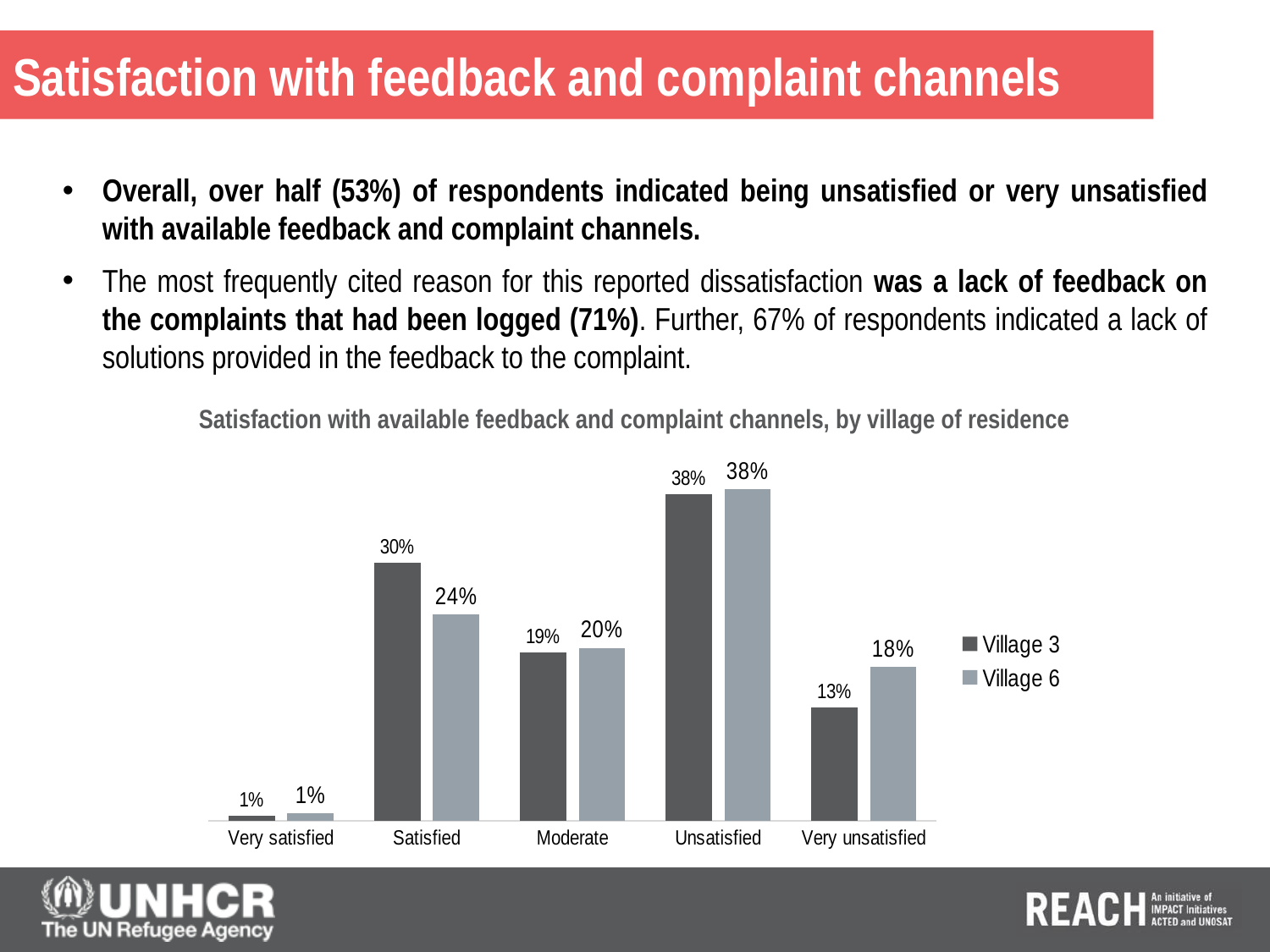
Which is larger in the Satisfied category, Village 3 or Village 6? Village 3 What is the difference between Village 3 and Village 6 in the Satisfied category? 6% What is the value for Village 3 in the Satisfied category? 30% What is the value for Village 6 in the Very unsatisfied category? 18% What is the value for Village 6 in the Moderate category? 20% What is the title of the chart? Satisfaction with available feedback and complaint channels, by village of residence Which category has the highest value for Village 3? Unsatisfied How many series does the legend list? 2 How many categories are shown on the x axis? 5 What kind of chart is shown on the slide? Bar chart What is the difference between Village 6 and Village 3 in the Very unsatisfied category? 5% Which category has the lowest value for Village 6? Very satisfied